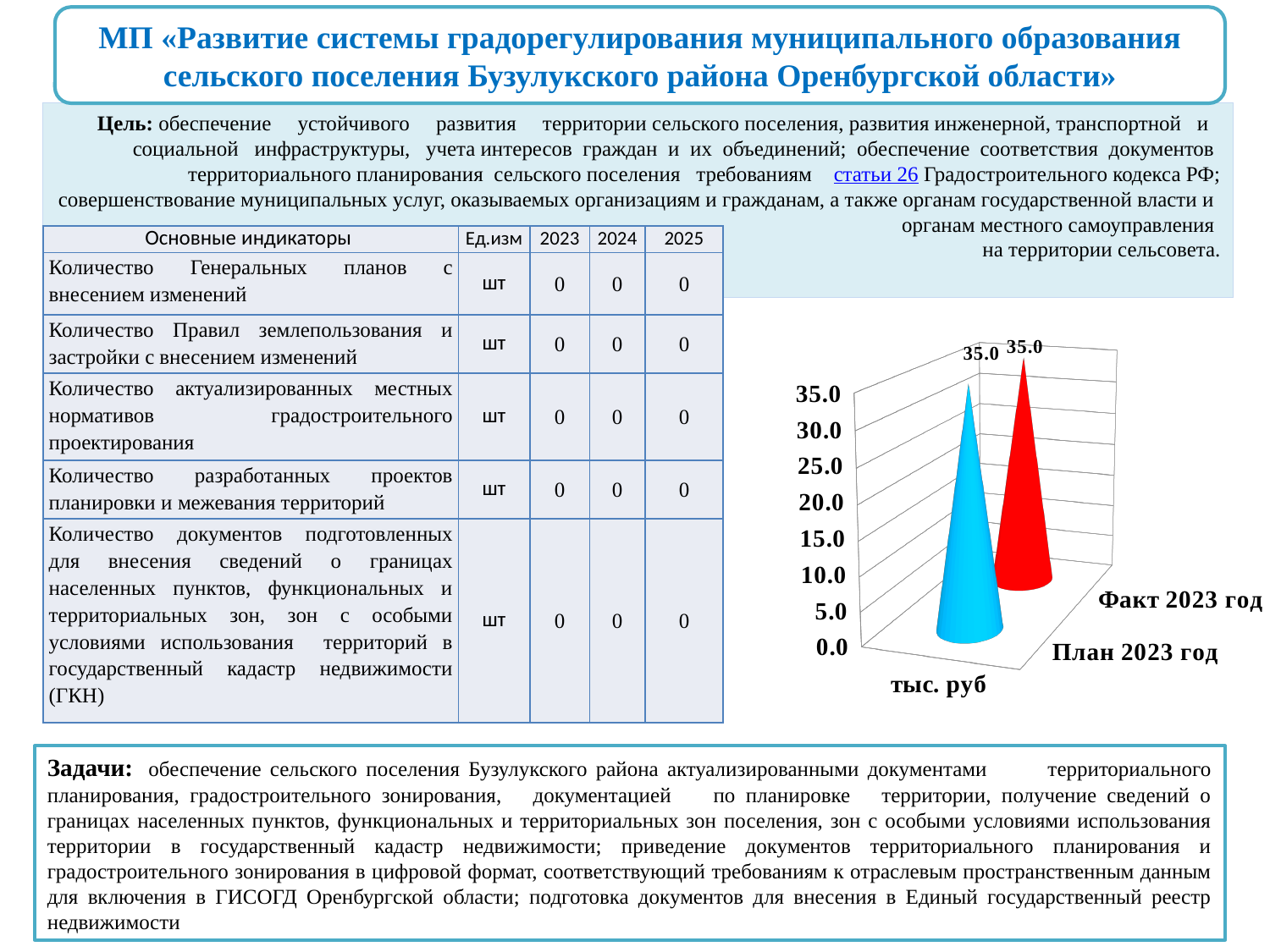
What is the value for План 2023 год on the chart? 35.0 What colour is the bar for Факт 2023 год on the chart? red Is the value for Факт 2023 год greater or less than 20.0? greater How many categories are plotted on the chart? 2 What kind of chart is shown on the slide? bar chart What is the highest tick value shown on the chart's vertical axis? 35.0 What is the value for Факт 2023 год on the chart? 35.0 What is the difference between the values for Факт 2023 год and План 2023 год on the chart? 0.0 Is the value for План 2023 год greater or less than 30.0? greater Do the values rise, fall or stay the same from План 2023 год to Факт 2023 год? stay the same What unit label is shown on the chart's axis? тыс. руб